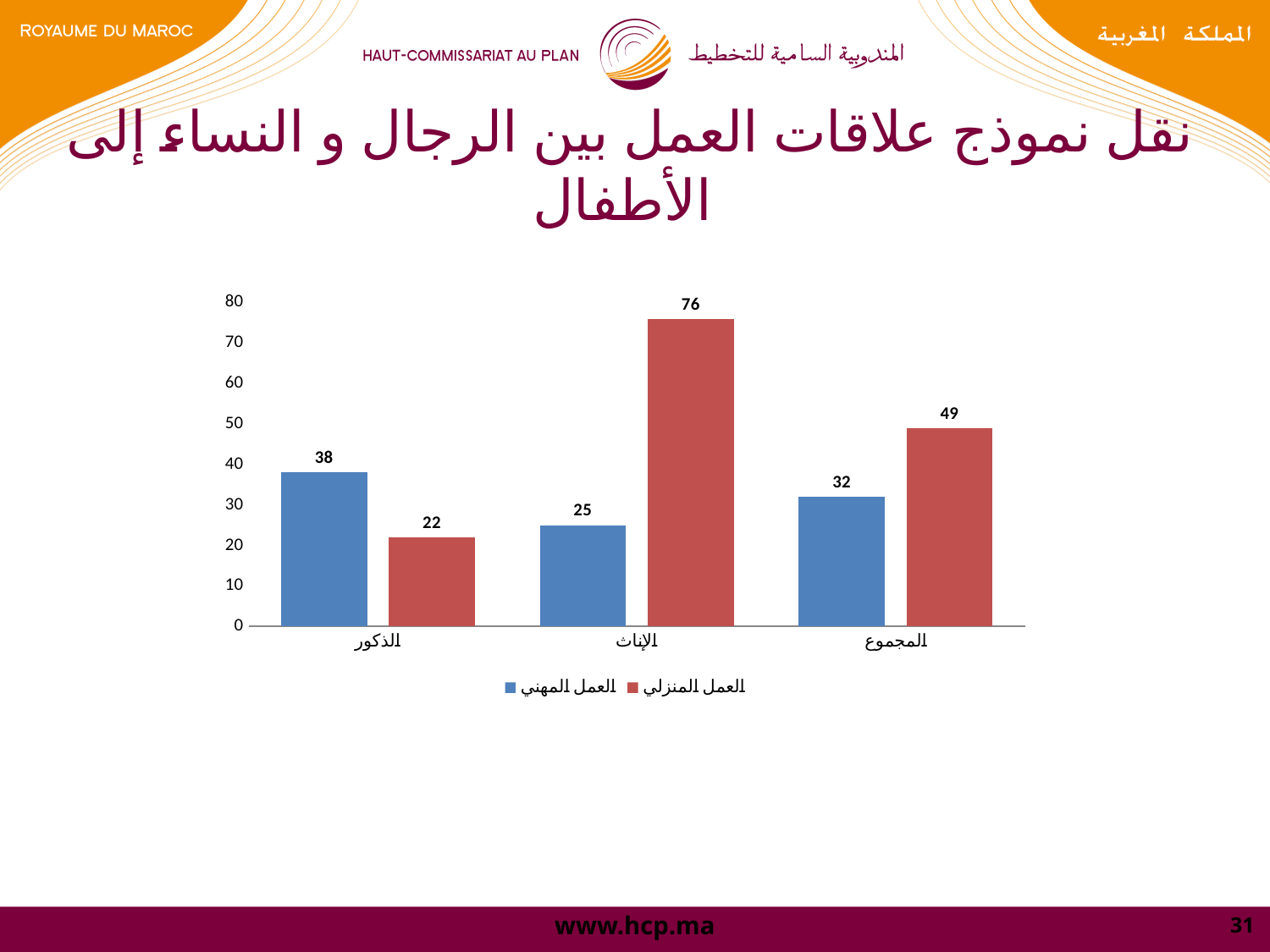
What is the difference between العمل المهني and العمل المنزلي for الإناث? 51 How many series does the legend list? 2 What is the value of العمل المنزلي for الذكور? 22 Which category has the lowest value for العمل المنزلي? الذكور Which category has the highest value for العمل المهني? الذكور For الذكور, which is larger: العمل المنزلي or العمل المهني? العمل المهني Which colour represents العمل المهني in the chart? Blue What is the value of العمل المهني for الإناث? 25 What kind of chart is shown on the slide? Bar chart How many categories are shown on the x axis? 3 What is the value of العمل المهني for المجموع? 32 What is the value of العمل المنزلي for الإناث? 76